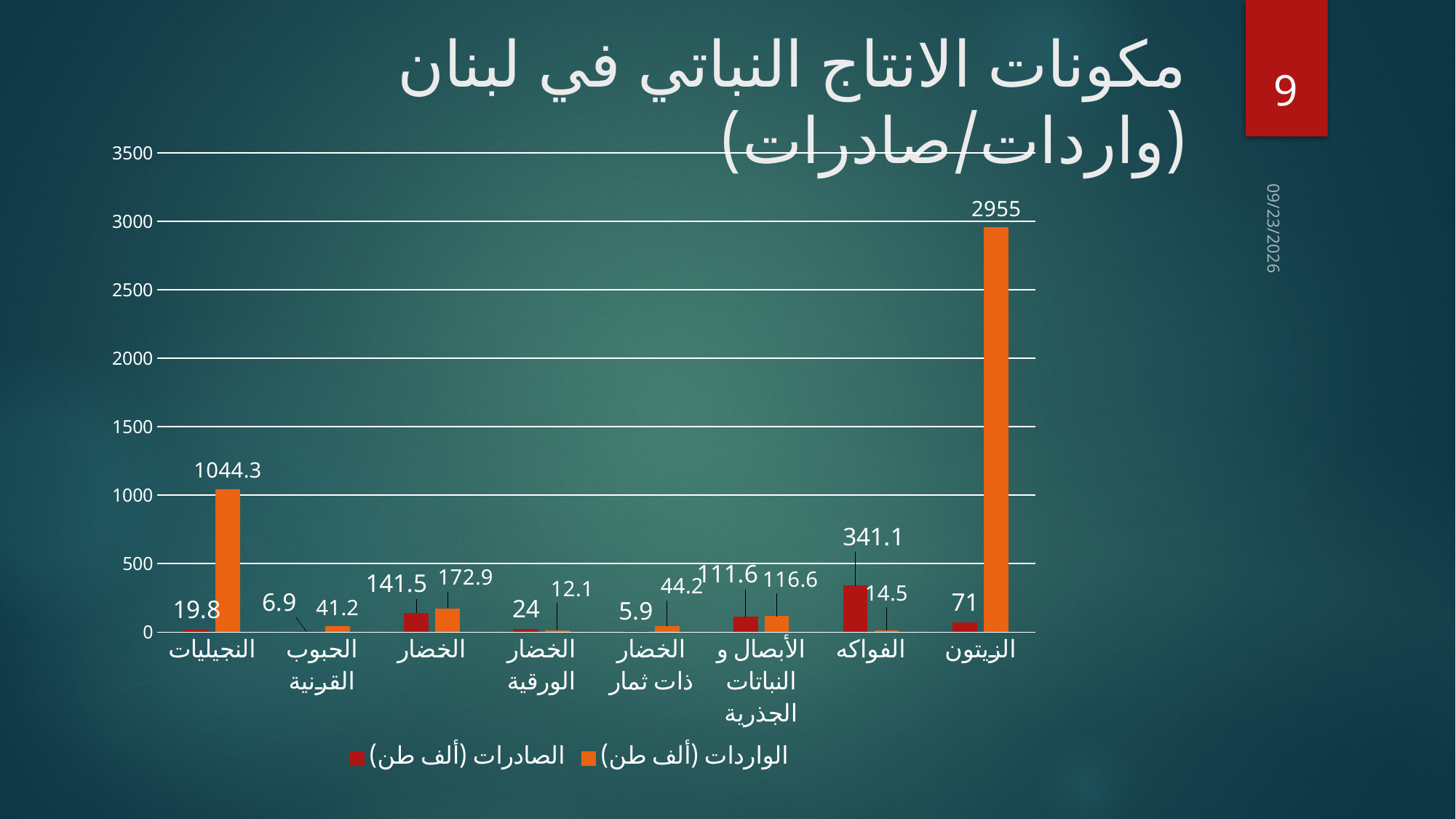
Which category has the highest value of الواردات (ألف طن)? الزيتون What is the value of الصادرات (ألف طن) for الفواكه? 341.1 What is the difference between الواردات (ألف طن) and الصادرات (ألف طن) for الخضار? 31.4 Which is larger for الفواكه: الصادرات (ألف طن) or الواردات (ألف طن)? الصادرات (ألف طن) What is the value of الواردات (ألف طن) for النجيليات? 1044.3 Which category has the lowest value of الصادرات (ألف طن)? الخضار ذات ثمار Is the value of الواردات (ألف طن) for النجيليات greater or less than 1000? greater What type of chart is shown on the slide? bar chart What is the value of الصادرات (ألف طن) for الخضار الورقية? 24 How many series does the legend list? 2 What is the value of الواردات (ألف طن) for الزيتون? 2955 How many categories are shown on the x axis? 8